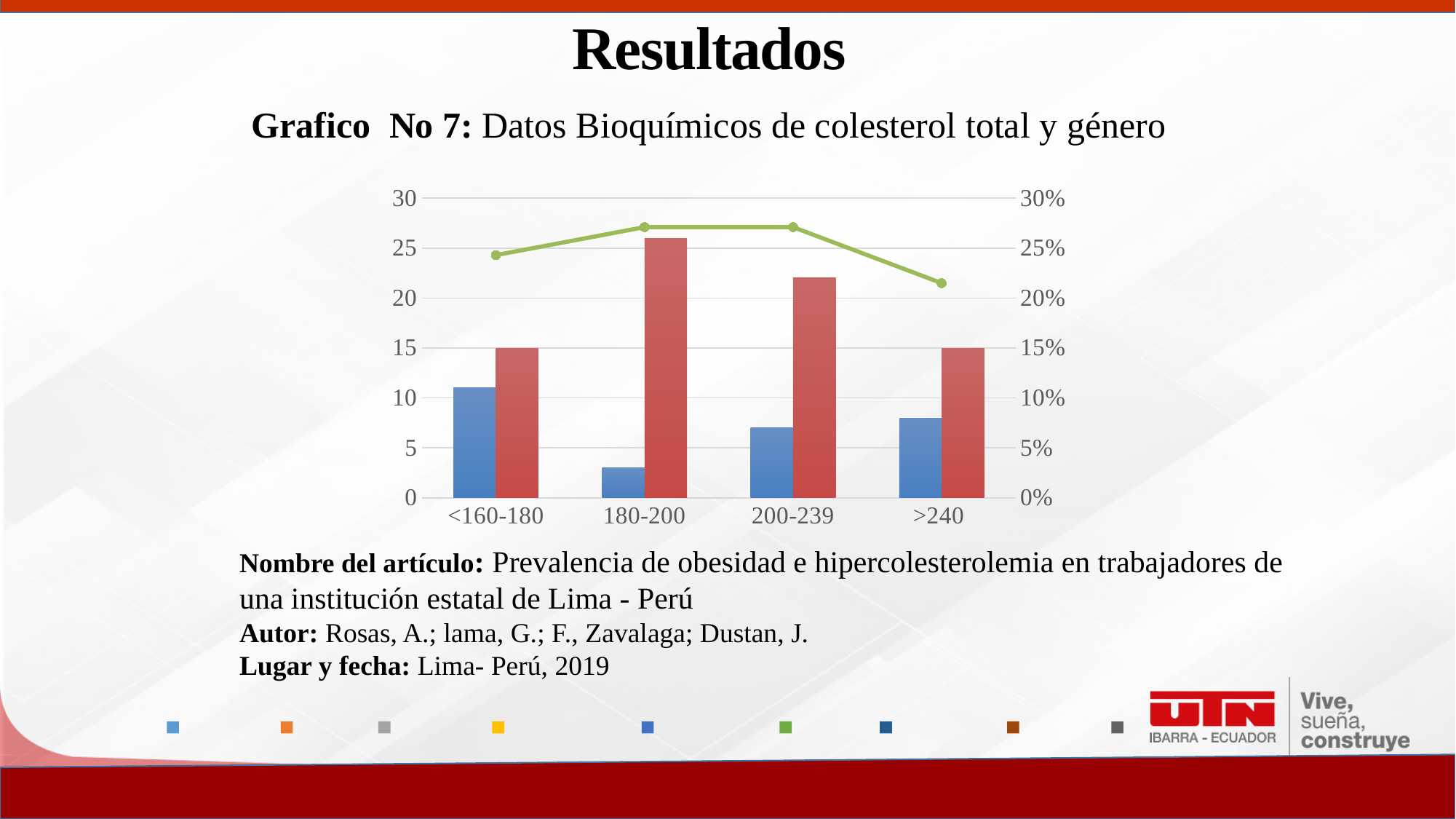
Is the red bar for 200-239 greater or less than 20? greater Is the red bar for 180-200 greater or less than 25? greater Is the green line value for >240 greater or less than 25%? less Which category has the tallest red bar? 180-200 What kind of chart is shown on the slide? Combined bar and line chart Which category has the shortest blue bar? 180-200 Which is larger for the 200-239 category, the blue bar or the red bar? the red bar Which category has the tallest blue bar? <160-180 What is the title of the chart on the slide? Grafico No 7: Datos Bioquímicos de colesterol total y género How many categories are shown on the x axis of the chart? 4